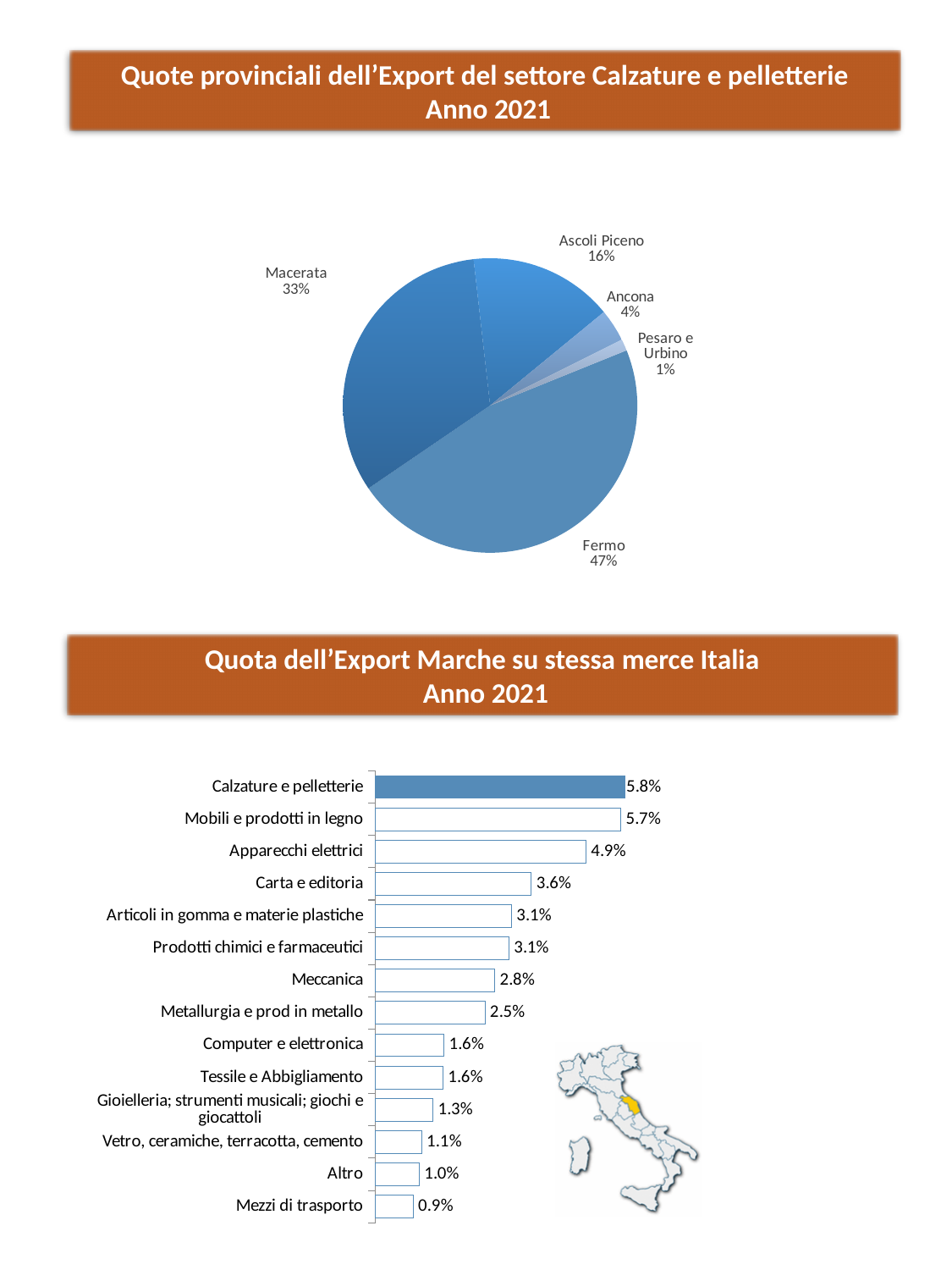
In the pie chart 'Quote provinciali dell'Export del settore Calzature e pelletterie', which province has the smallest share? Pesaro e Urbino In the bar chart 'Quota dell'Export Marche su stessa merce Italia', how many categories are shown? 14 What type of chart is the bottom chart 'Quota dell'Export Marche su stessa merce Italia'? Bar chart In the pie chart 'Quote provinciali dell'Export del settore Calzature e pelletterie', how many provinces (slices) are shown? 5 In the bar chart 'Quota dell'Export Marche su stessa merce Italia', what is the value for Carta e editoria? 3.6% In the pie chart 'Quote provinciali dell'Export del settore Calzature e pelletterie', what share does Fermo hold? 47% In the bar chart 'Quota dell'Export Marche su stessa merce Italia', what is the difference between Calzature e pelletterie and Mobili e prodotti in legno? 0.1% In the bar chart 'Quota dell'Export Marche su stessa merce Italia', which category has the highest value? Calzature e pelletterie In the pie chart 'Quote provinciali dell'Export del settore Calzature e pelletterie', what is the difference between the shares of Macerata and Ascoli Piceno? 17% In the bar chart 'Quota dell'Export Marche su stessa merce Italia', which category has the lowest value? Mezzi di trasporto In the pie chart 'Quote provinciali dell'Export del settore Calzature e pelletterie', which is larger, the share of Ancona or the share of Ascoli Piceno? Ascoli Piceno What type of chart is used in the top chart 'Quote provinciali dell'Export del settore Calzature e pelletterie'? Pie chart